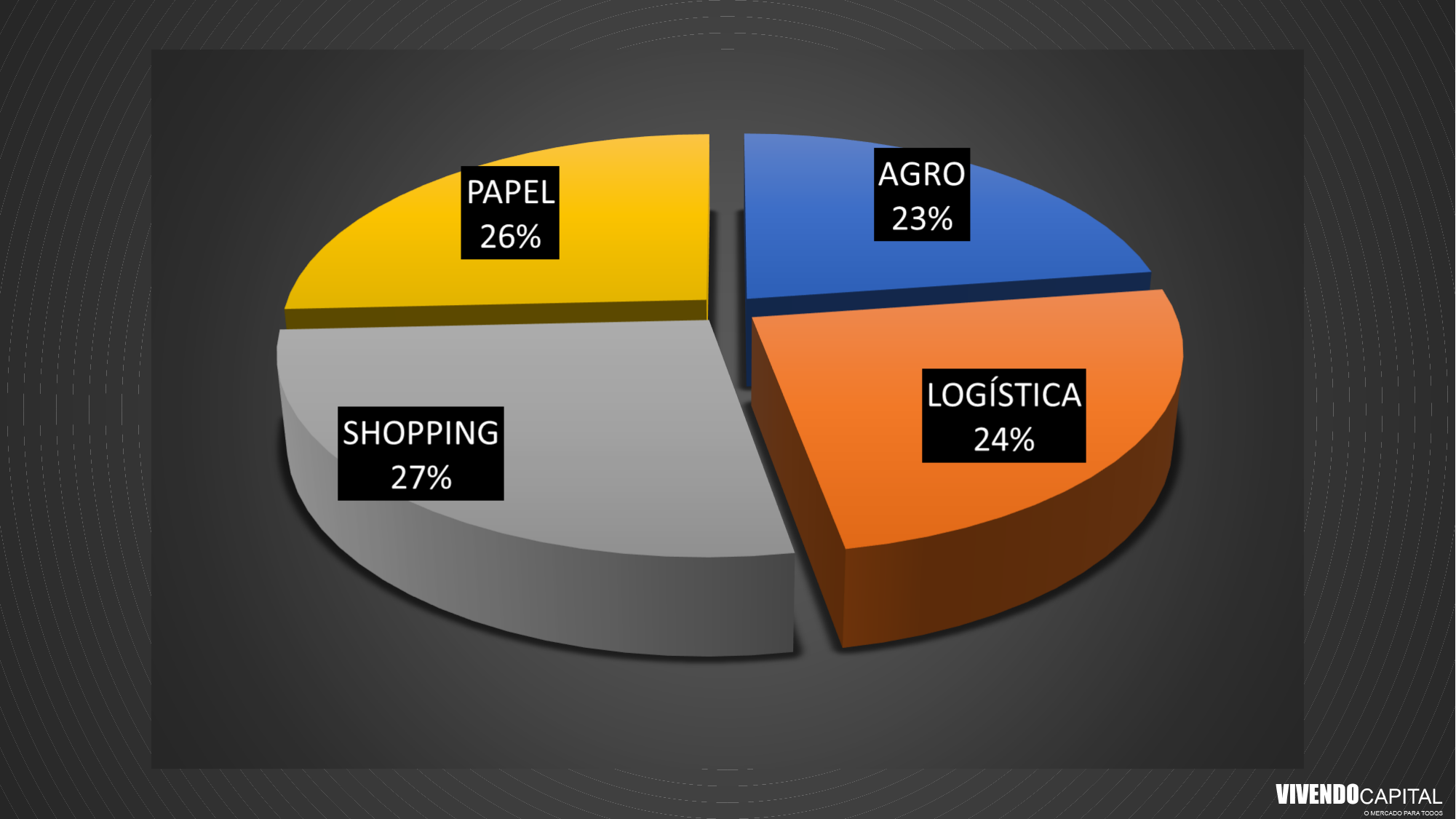
What percentage does the AGRO slice represent? 23% What colour is the AGRO slice? Blue What percentage does the PAPEL slice represent? 26% How many categories are shown in the pie chart? 4 Which category has the smallest share of the pie? AGRO Which category has the largest share of the pie? SHOPPING What kind of chart is shown on the slide? Pie chart What is the difference in percentage points between PAPEL and LOGÍSTICA? 2 What is the difference in percentage points between SHOPPING and AGRO? 4 Which is larger, the PAPEL share or the LOGÍSTICA share? PAPEL What percentage does the LOGÍSTICA slice represent? 24% What percentage does the SHOPPING slice represent? 27%